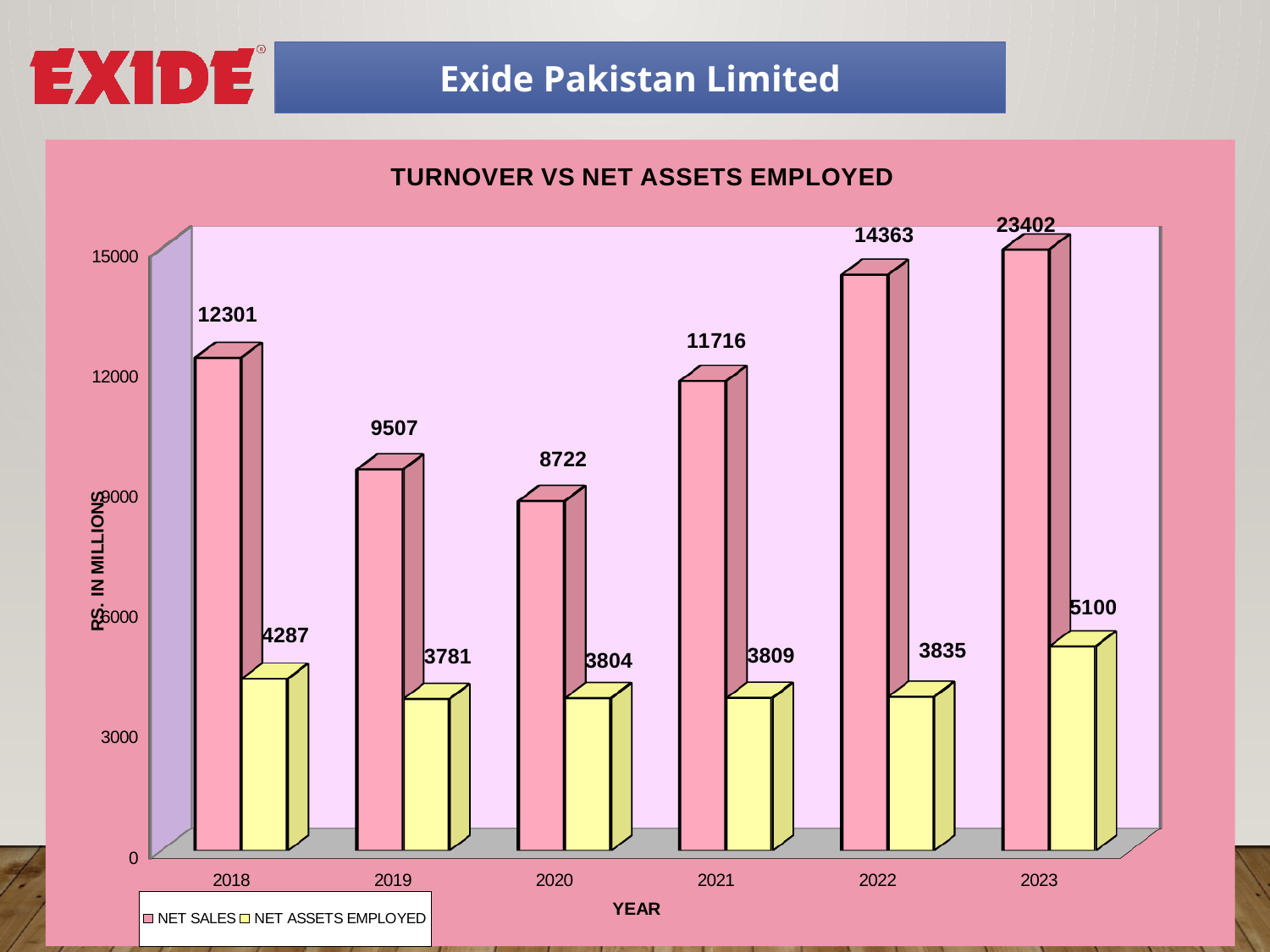
Which is larger: NET ASSETS EMPLOYED in 2018 or NET ASSETS EMPLOYED in 2022? 2018 What kind of chart is shown on the slide? Bar chart Which year has the lowest NET ASSETS EMPLOYED value? 2019 What is the difference between NET SALES in 2022 and NET SALES in 2021? 2647 What is the NET SALES value for 2020? 8722 How many years are shown on the x axis? 6 What is the NET ASSETS EMPLOYED value for 2019? 3781 Which year has the highest NET SALES value? 2023 How many series does the legend list? 2 Which year has the lowest NET SALES value? 2020 What is the NET SALES value for 2021? 11716 What is the title of the chart? TURNOVER VS NET ASSETS EMPLOYED